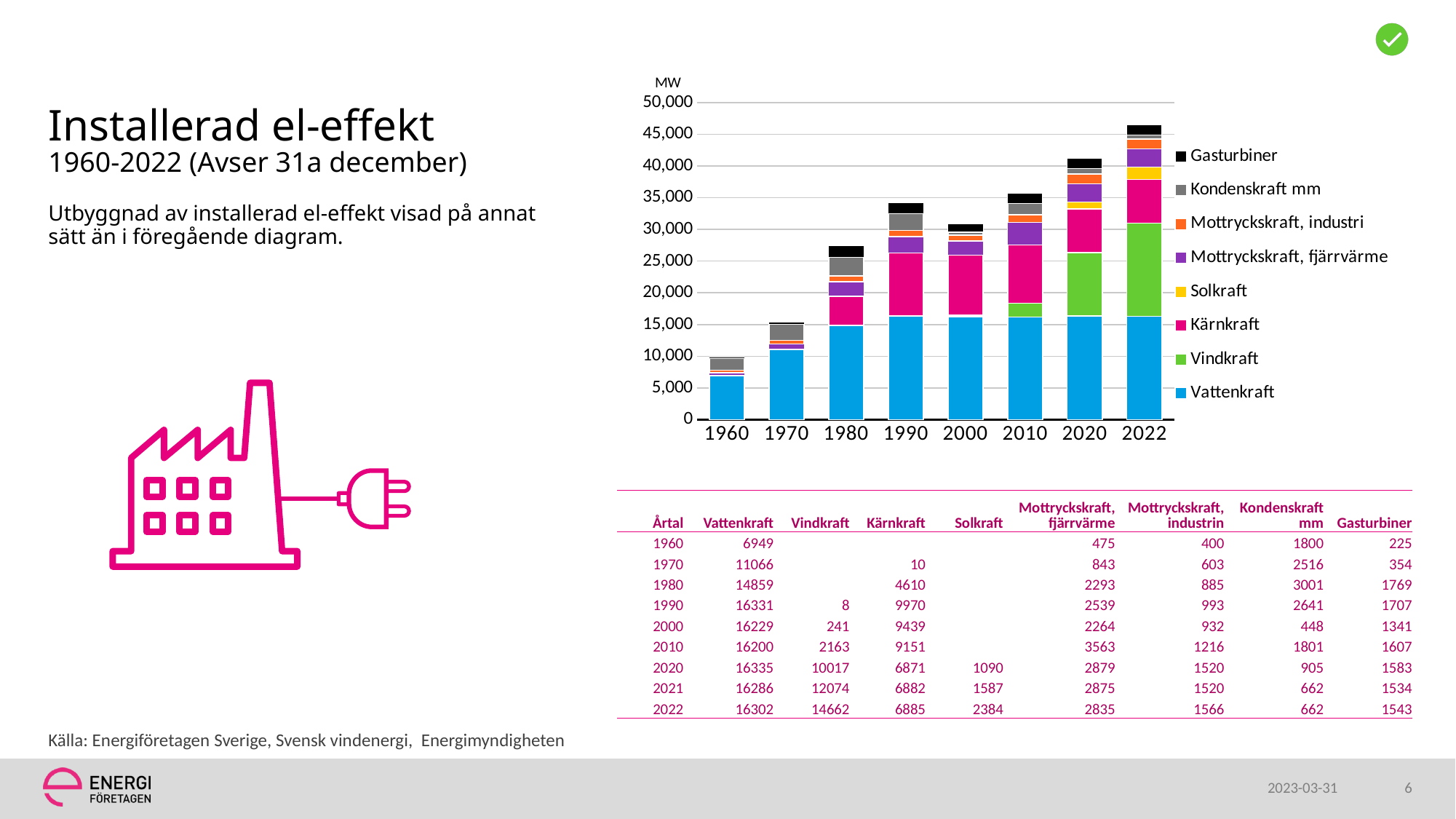
In 2022, which is larger: Vindkraft or Kärnkraft? Vindkraft What unit is shown at the top of the chart's y axis? MW What is the Vattenkraft value for 1960 according to the table below the chart? 6949 By how much did Vindkraft increase from 2020 to 2022, using the table values? 4645 What is the Vindkraft value for 2022 according to the table below the chart? 14662 Is the total installed capacity for 2000 greater or less than 35,000 MW? less Which year has the highest total installed capacity in the chart? 2022 What kind of chart is shown on the slide? Stacked bar chart Which year has the lowest total installed capacity in the chart? 1960 Is the total installed capacity for 1990 greater or less than 30,000 MW? greater How many series does the chart legend list? 8 How many years (bars) are plotted on the x axis of the chart? 8